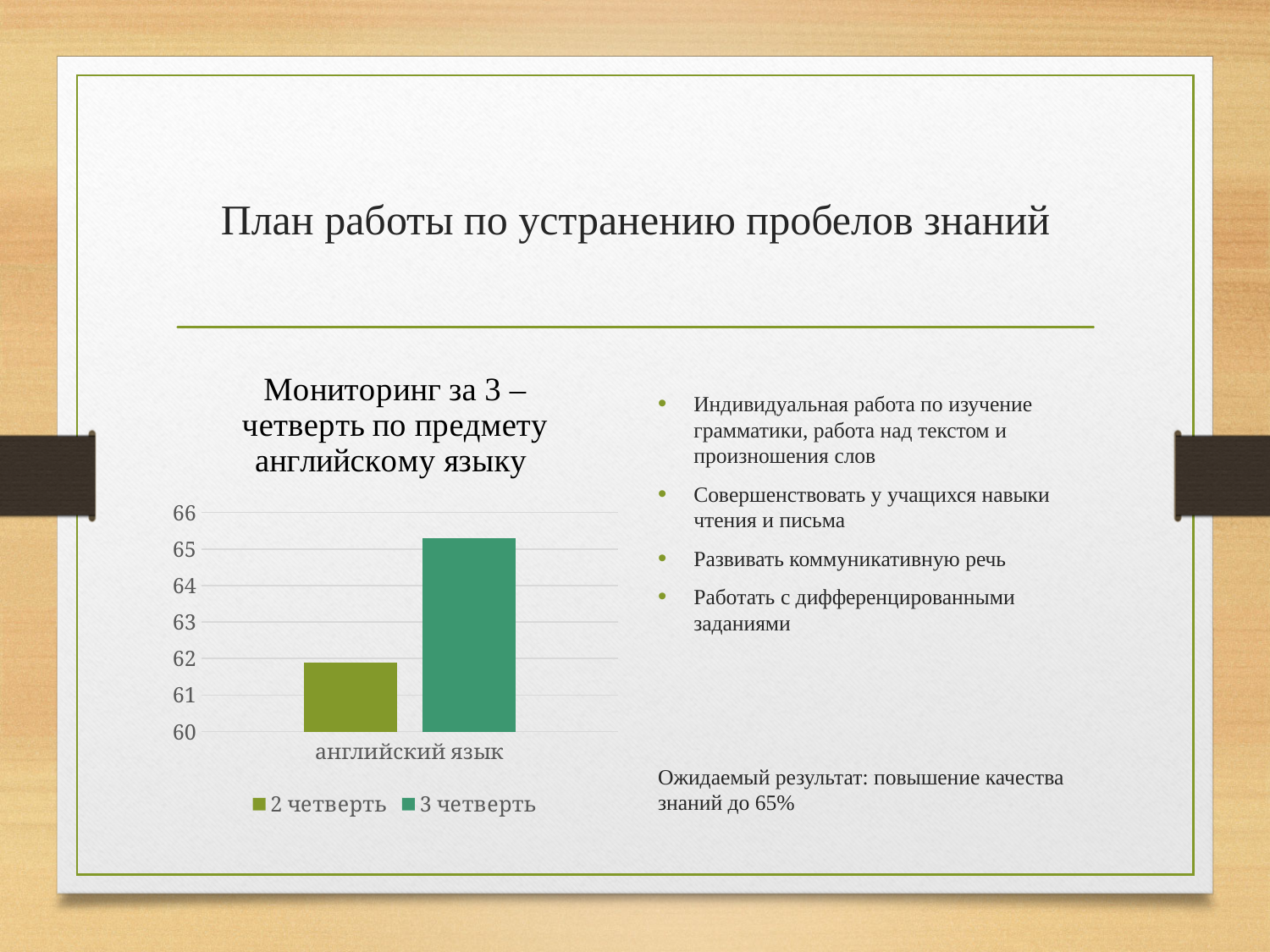
How many categories are shown on the x axis of the chart? 1 Which series shows the lowest value in the chart? 2 четверть Which series shows the highest value in the chart? 3 четверть Is the value for 2 четверть greater or less than 61? greater How many series does the chart legend list? 2 Is the value for 3 четверть greater or less than 64? greater What category label appears on the x axis of the chart? английский язык Which series has the larger value for английский язык: 2 четверть or 3 четверть? 3 четверть Is the value for 3 четверть greater or less than 66? less What kind of chart is shown on the slide? bar chart What is the title of the chart? Мониторинг за 3 – четверть по предмету английскому языку